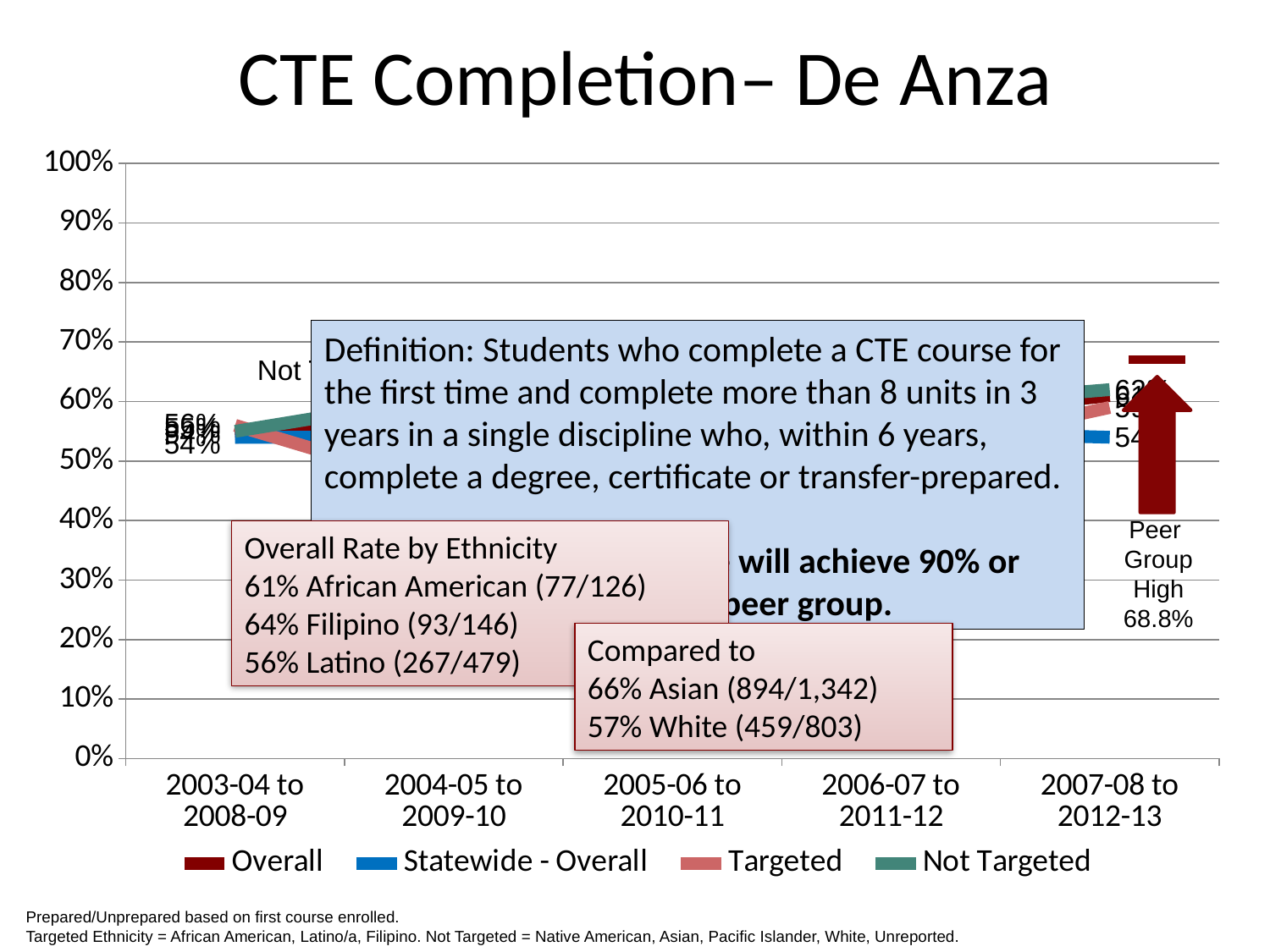
What is the Peer Group High value noted on the chart? 68.8% How many cohort periods are shown along the x axis? 5 Is the value for Overall in 2003-04 to 2008-09 greater or less than 70%? less Which series are listed in the legend? Overall, Statewide - Overall, Targeted, Not Targeted What is the title of the chart? CTE Completion– De Anza What is the maximum value shown on the y axis? 100% What kind of chart is shown on the slide? line chart Is the value for Statewide - Overall in 2003-04 to 2008-09 greater or less than 40%? greater Is the value for Targeted in 2007-08 to 2012-13 greater or less than 80%? less How many series does the legend list? 4 What is the first cohort period labelled on the x axis? 2003-04 to 2008-09